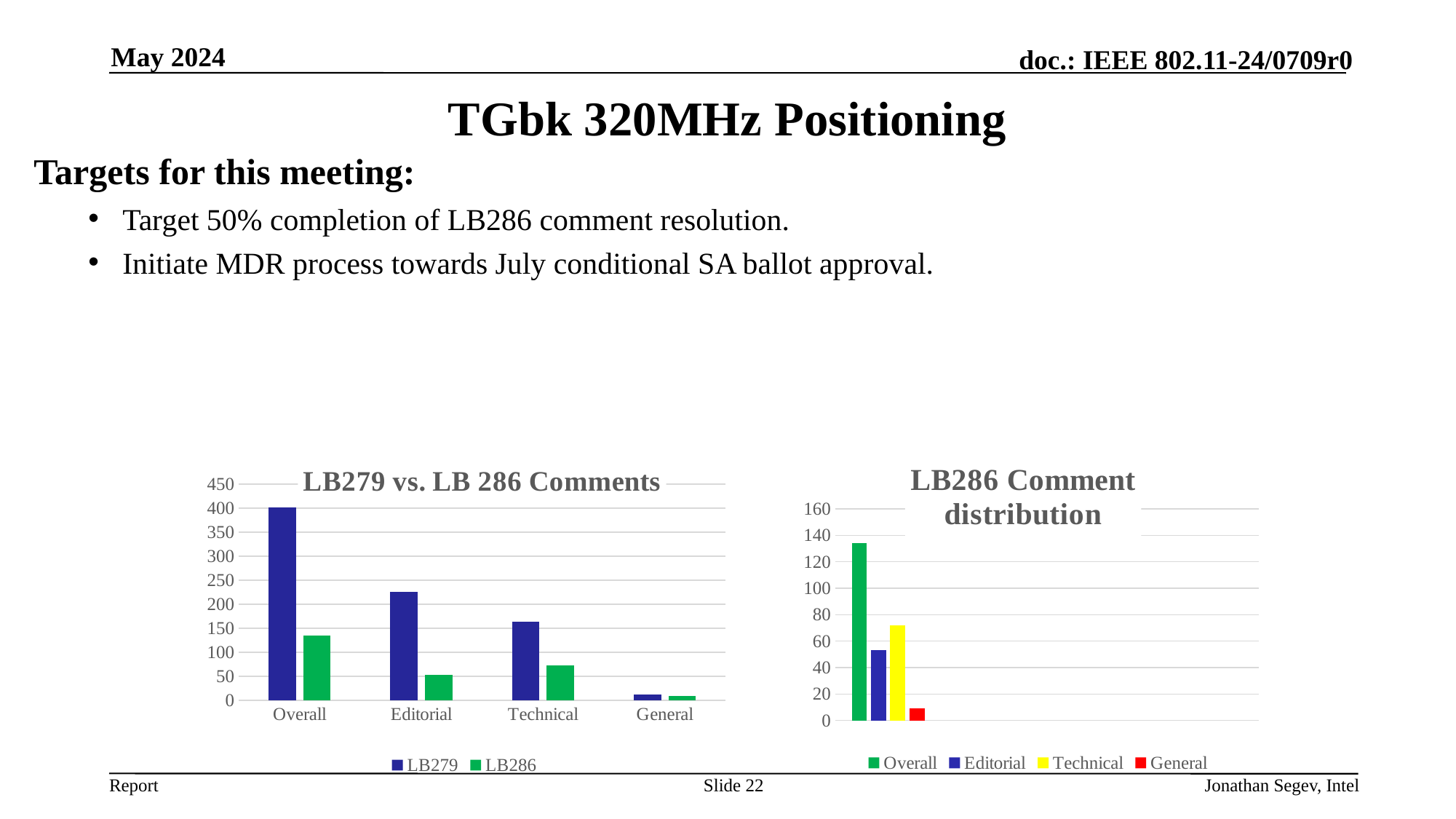
What kind of chart is the "LB279 vs. LB 286 Comments" chart? bar chart In the "LB279 vs. LB 286 Comments" chart, is the LB286 value for Editorial greater or less than 100? less In the "LB286 Comment distribution" chart, which category has the lowest value? General In the "LB279 vs. LB 286 Comments" chart, is the LB279 value for Overall greater or less than 350? greater How many categories are shown on the x axis of the "LB279 vs. LB 286 Comments" chart? 4 In the "LB279 vs. LB 286 Comments" chart, which category has the lowest LB279 value? General In the "LB279 vs. LB 286 Comments" chart, which is larger for LB286: Technical or Editorial? Technical What kind of chart is the "LB286 Comment distribution" chart? bar chart How many series does the legend of the "LB279 vs. LB 286 Comments" chart list? 2 In the "LB279 vs. LB 286 Comments" chart, which category has the highest LB279 value? Overall In the "LB286 Comment distribution" chart, is the value for Technical greater or less than 60? greater In the "LB286 Comment distribution" chart, which category has the highest value? Overall